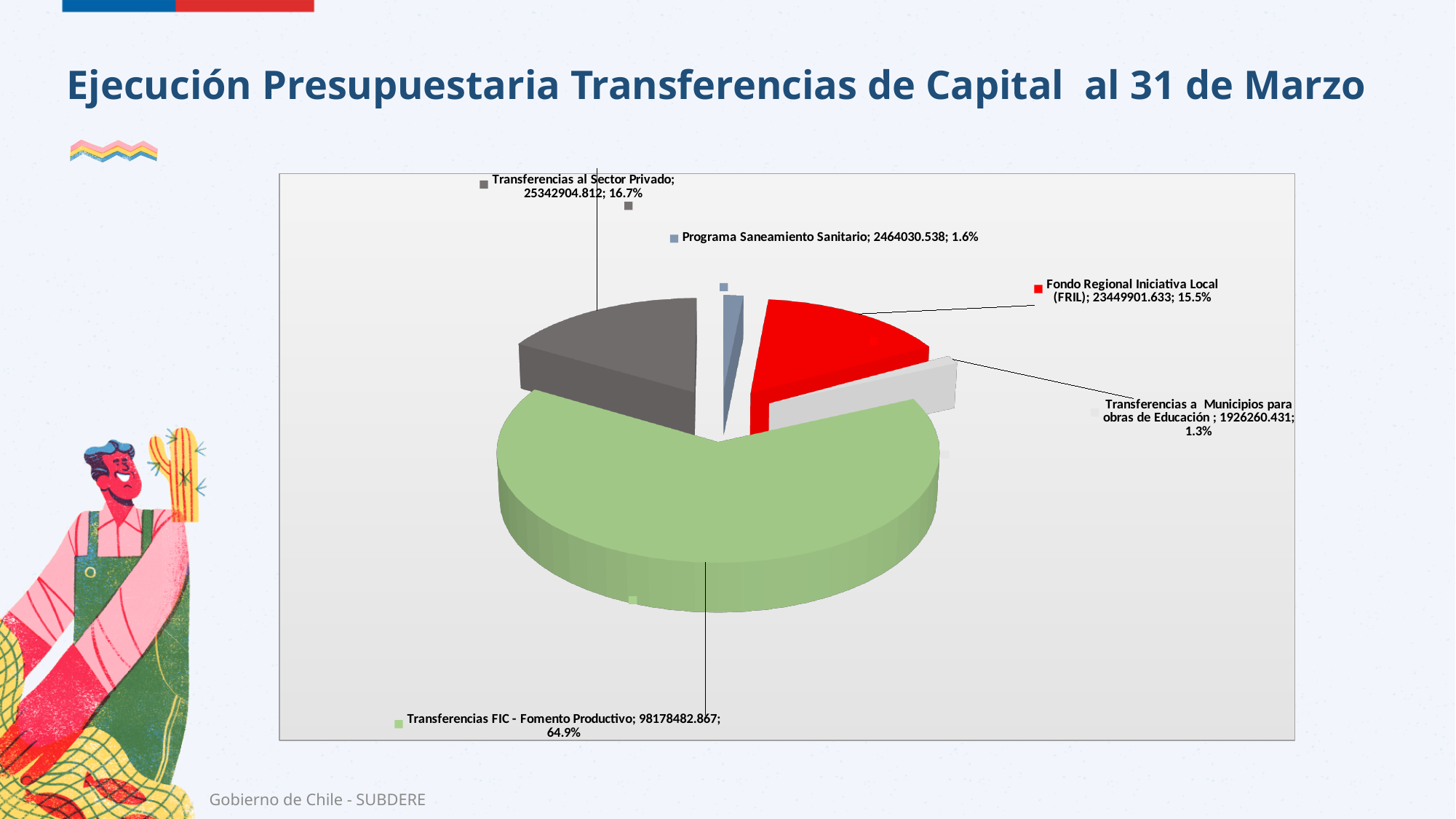
What percentage share does Fondo Regional Iniciativa Local (FRIL) have? 15.5% What kind of chart is shown on the slide? Pie chart What is the difference in percentage share between Transferencias FIC - Fomento Productivo and Transferencias al Sector Privado? 48.2% What colour is the slice for Fondo Regional Iniciativa Local (FRIL)? Red What is the value shown for Programa Saneamiento Sanitario? 2464030.538 What is the difference in value between Transferencias al Sector Privado and Fondo Regional Iniciativa Local (FRIL)? 1893003.179 Which category has the largest slice of the pie? Transferencias FIC - Fomento Productivo What percentage share does Transferencias al Sector Privado have? 16.7% Which is larger: the share for Transferencias al Sector Privado or for Fondo Regional Iniciativa Local (FRIL)? Transferencias al Sector Privado Which category has the smallest slice of the pie? Transferencias a Municipios para obras de Educación How many slices does the pie chart have? 5 What is the value shown for Transferencias FIC - Fomento Productivo? 98178482.867